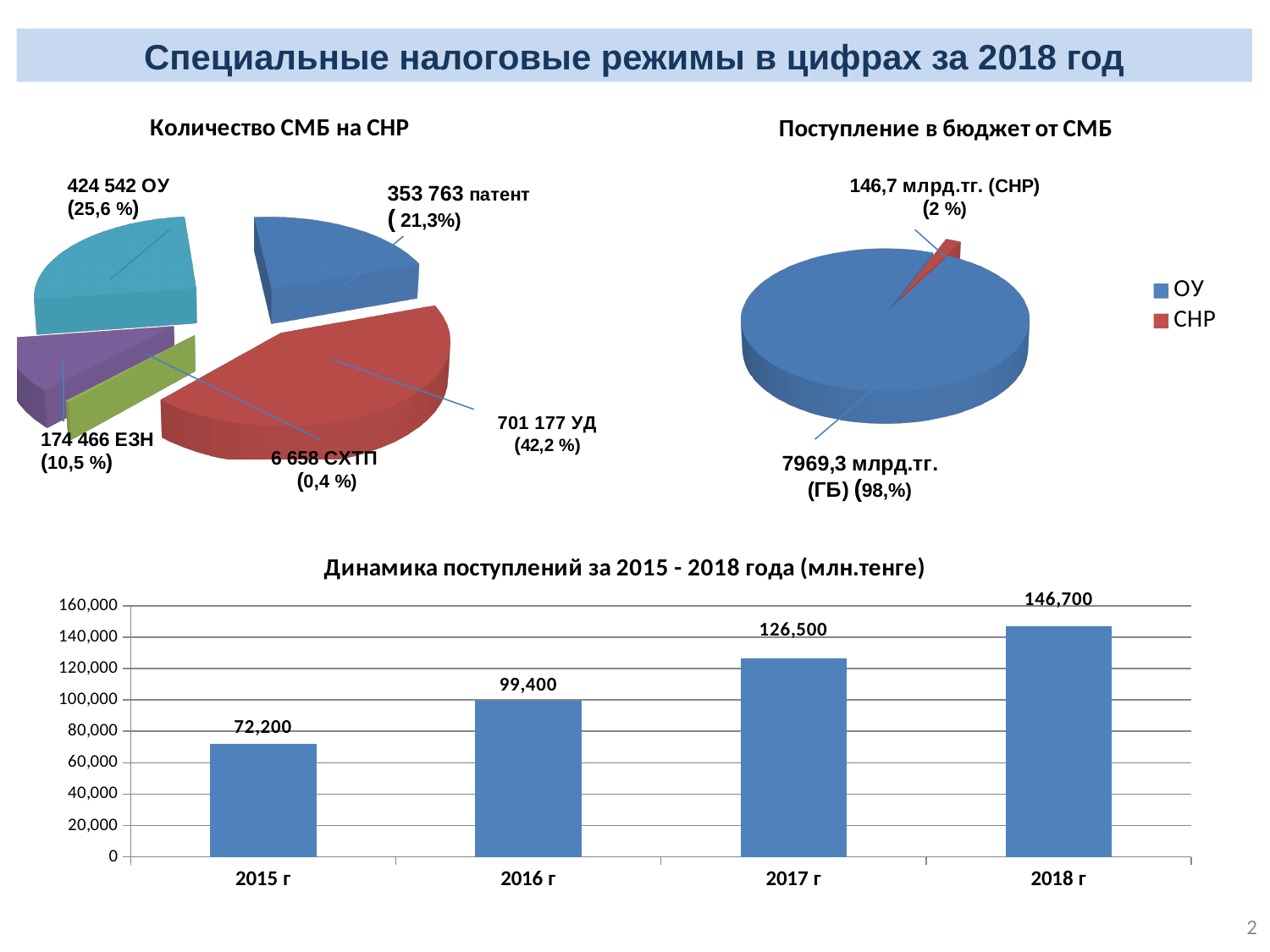
In the chart 'Динамика поступлений за 2015 - 2018 года (млн.тенге)', which year has the lowest value? 2015 г In the chart 'Динамика поступлений за 2015 - 2018 года (млн.тенге)', which year has the highest value? 2018 г How many entries does the legend of the pie chart 'Поступление в бюджет от СМБ' list? 2 In the chart 'Динамика поступлений за 2015 - 2018 года (млн.тенге)', what is the difference between the values for 2018 г and 2015 г? 74,500 In the chart 'Динамика поступлений за 2015 - 2018 года (млн.тенге)', what is the value for 2017 г? 126,500 In the pie chart 'Количество СМБ на СНР', what is the number for ЕЗН? 174 466 In the chart 'Динамика поступлений за 2015 - 2018 года (млн.тенге)', do the values rise or fall from 2015 г to 2018 г? rise In the pie chart 'Количество СМБ на СНР', which category has the largest slice? УД In the pie chart 'Количество СМБ на СНР', what share does УД have? 42,2 % What kind of chart is 'Динамика поступлений за 2015 - 2018 года (млн.тенге)'? bar chart How many years are shown in the chart 'Динамика поступлений за 2015 - 2018 года (млн.тенге)'? 4 In the chart 'Динамика поступлений за 2015 - 2018 года (млн.тенге)', is the value for 2016 г greater or less than 80,000? greater